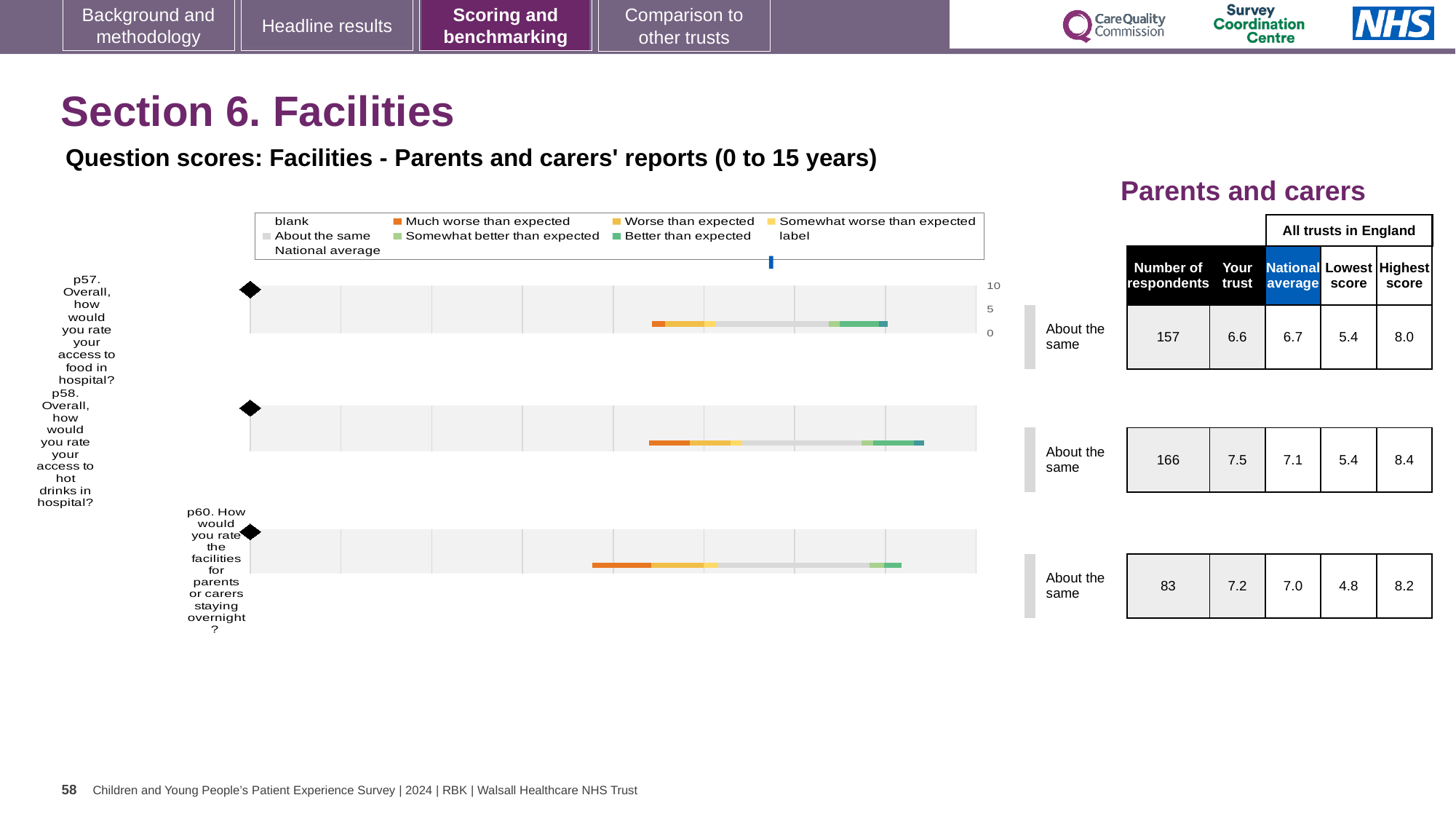
What type of chart is used to show the question scores on this slide? bar chart What is the national average score for p58 (access to hot drinks in hospital)? 7.1 By how much does the 'Your trust' score for p58 exceed the national average for p58? 0.4 What is the 'Your trust' score for p57 (access to food in hospital)? 6.6 What benchmark category is shown for all three questions on this slide? About the same How many respondents answered p60 (facilities for parents or carers staying overnight)? 83 Which question has the lowest 'Your trust' score? p57 (access to food in hospital) How many survey questions are plotted in the Facilities chart on this slide? 3 Which question has the highest 'Your trust' score? p58 (access to hot drinks in hospital) What is the highest score among all trusts in England for p58? 8.4 What is the difference between the highest and lowest scores across all trusts in England for p57? 2.6 For p60, which is larger: the 'Your trust' score or the national average? Your trust